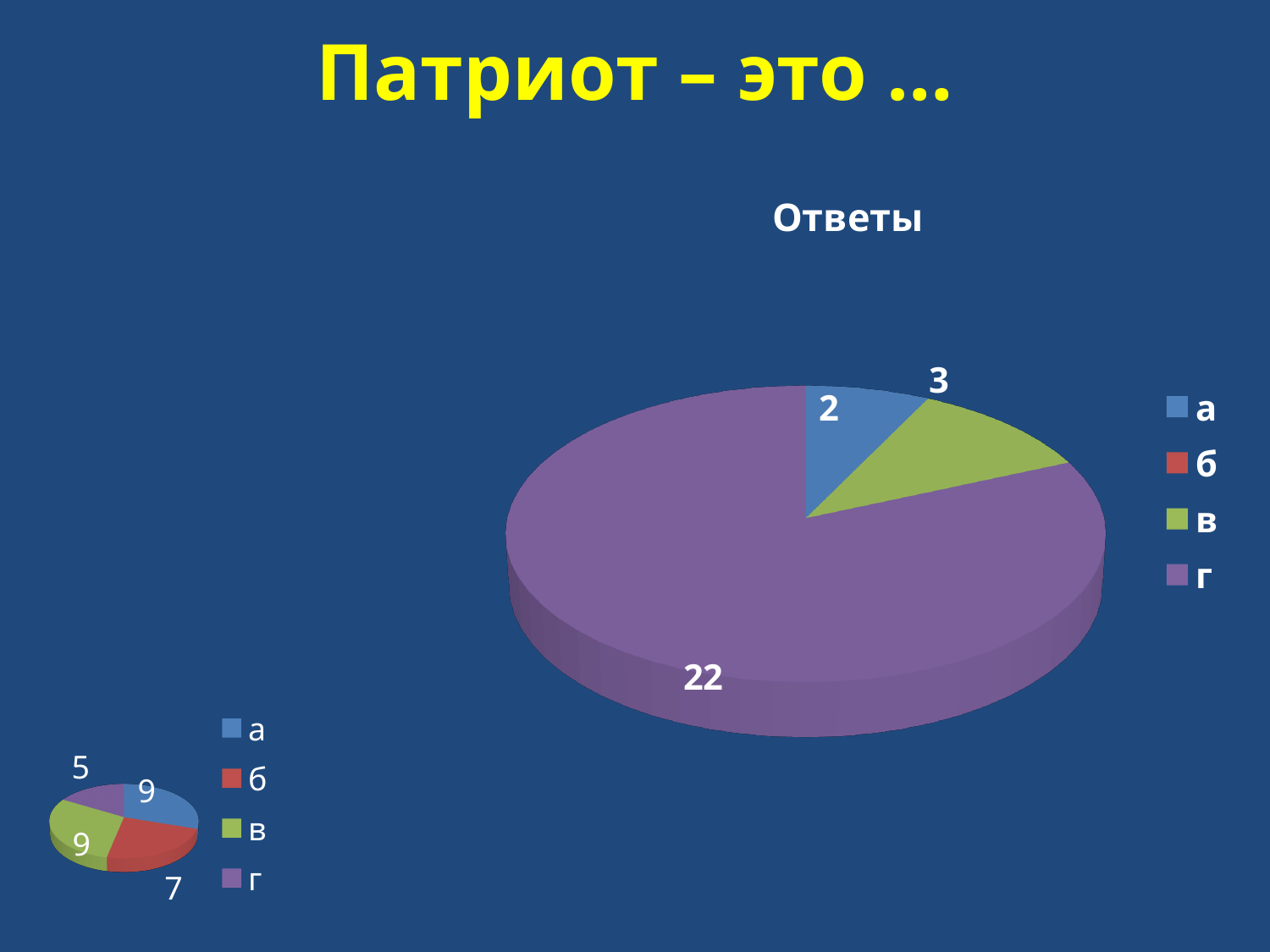
In the small pie chart at the bottom left of the slide, what share of the total does slice а represent? 30% In the small pie chart at the bottom left of the slide, what is the value of slice г? 5 In the chart titled "Ответы", what is the difference between the values of г and в? 19 In the chart titled "Ответы", which category has the largest slice? г In the chart titled "Ответы", which is larger, the value for а or the value for в? в In the small pie chart at the bottom left of the slide, which category has the smallest slice? г In the small pie chart at the bottom left of the slide, what is the value of slice б? 7 What type of chart is the chart titled "Ответы"? Pie chart In the chart titled "Ответы", what is the value of slice а? 2 In the chart titled "Ответы", what is the value of slice в? 3 In the chart titled "Ответы", how many entries does the legend list? 4 In the chart titled "Ответы", what is the value of slice г? 22